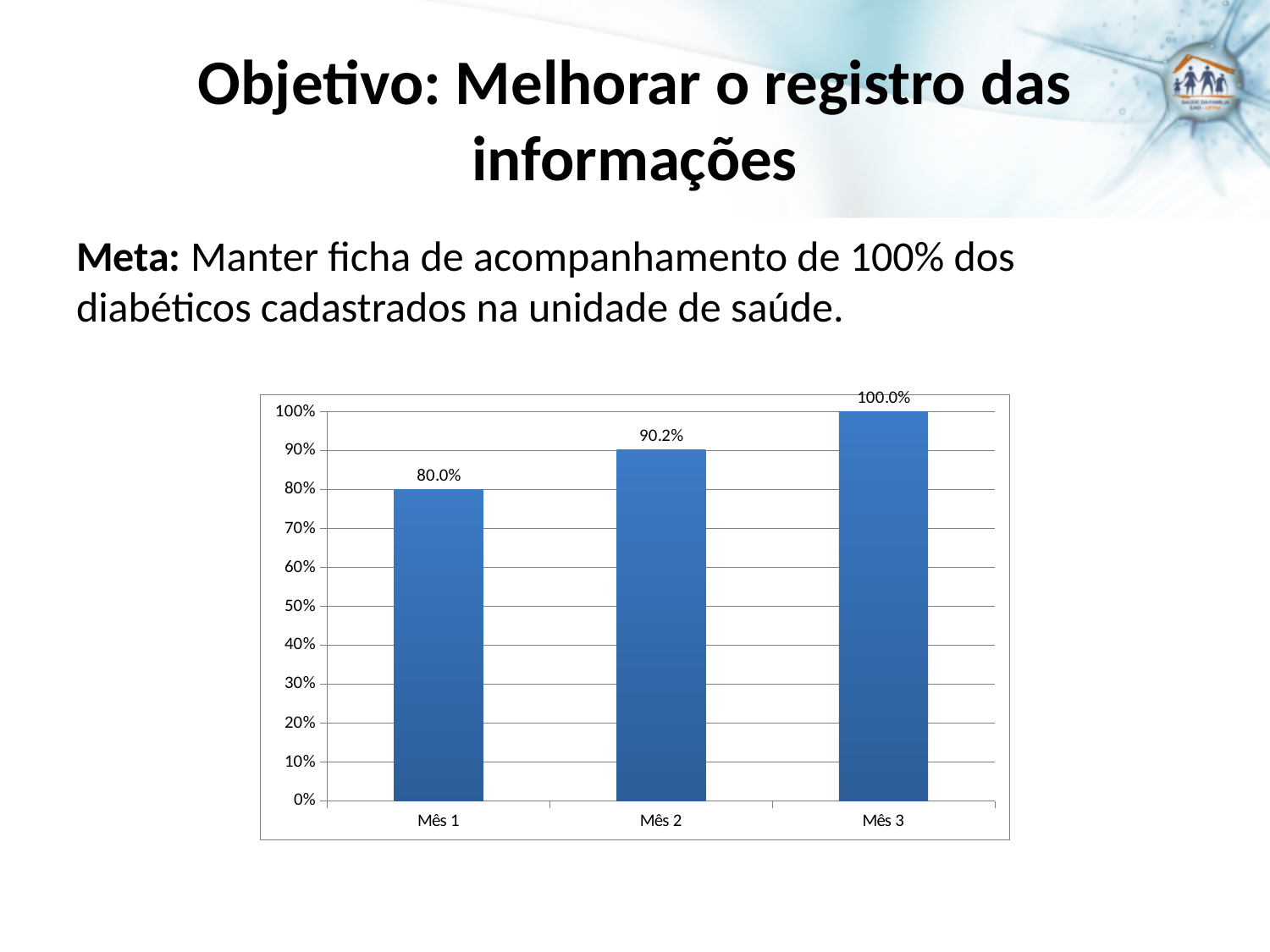
What is the difference between the values for Mês 2 and Mês 1? 10.2% Do the values rise or fall from Mês 1 to Mês 3? rise What kind of chart is shown on the slide? bar chart What is the value for Mês 1? 80.0% What is the value for Mês 3? 100.0% Is the value for Mês 2 greater or less than 90%? greater Which month has the lowest value? Mês 1 Which month has the highest value? Mês 3 How many categories are shown on the x axis? 3 What is the value for Mês 2? 90.2% Which is larger, the value for Mês 1 or the value for Mês 2? Mês 2 What is the difference between the values for Mês 3 and Mês 1? 20.0%